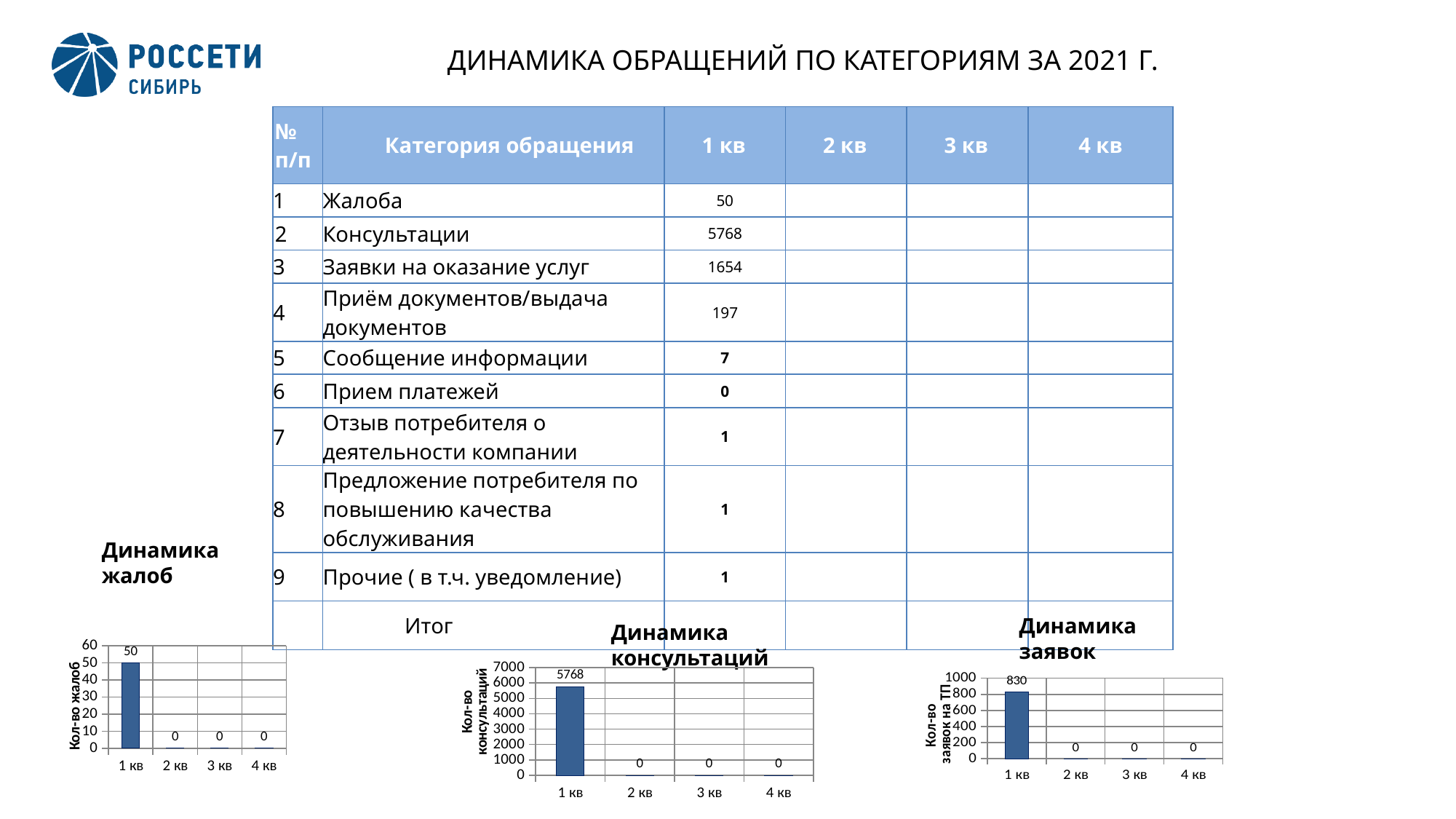
In the 'Динамика жалоб' chart, what is the value for 1 кв? 50 In the 'Динамика заявок' chart, what is the value for 1 кв? 830 What is the y-axis label of the 'Динамика жалоб' chart? Кол-во жалоб In the 'Динамика консультаций' chart, do the values rise or fall from 1 кв to 2 кв? fall In the 'Динамика консультаций' chart, what is the value for 1 кв? 5768 In the 'Динамика заявок' chart, which is larger, the value for 1 кв or the value for 4 кв? 1 кв In the 'Динамика консультаций' chart, what is the difference between the values for 1 кв and 2 кв? 5768 In the 'Динамика консультаций' chart, is the value for 1 кв greater or less than 5000? greater How many quarters are shown on the x axis of the 'Динамика жалоб' chart? 4 What kind of chart is 'Динамика заявок'? bar chart In the 'Динамика жалоб' chart, which quarter has the highest value? 1 кв In the 'Динамика заявок' chart, what is the value for 3 кв? 0